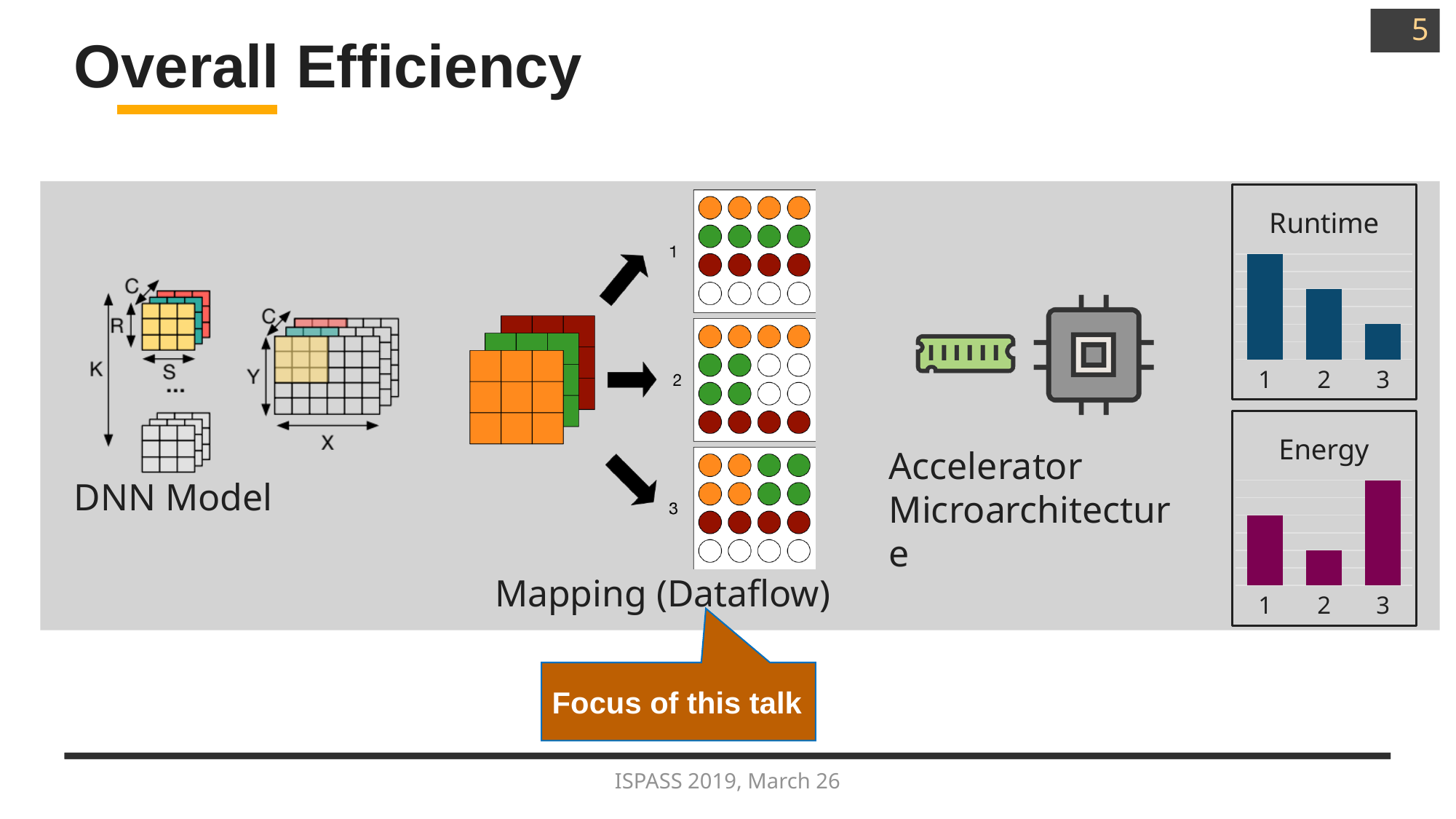
In the Runtime chart, which is larger, the bar for 2 or the bar for 3? 2 How many categories are shown in the Energy chart? 3 How many categories are shown in the Runtime chart? 3 In the Runtime chart, which category has the lowest bar? 3 What kind of chart is the Runtime chart? bar chart In the Energy chart, which is larger, the bar for 1 or the bar for 3? 3 What kind of chart is the Energy chart? bar chart In the Runtime chart, do the values rise or fall from category 1 to category 3? fall In the Energy chart, which category has the highest bar? 3 In the Runtime chart, which category has the highest bar? 1 In the Energy chart, which category has the lowest bar? 2 What is the title of the lower chart on the right side of the slide? Energy